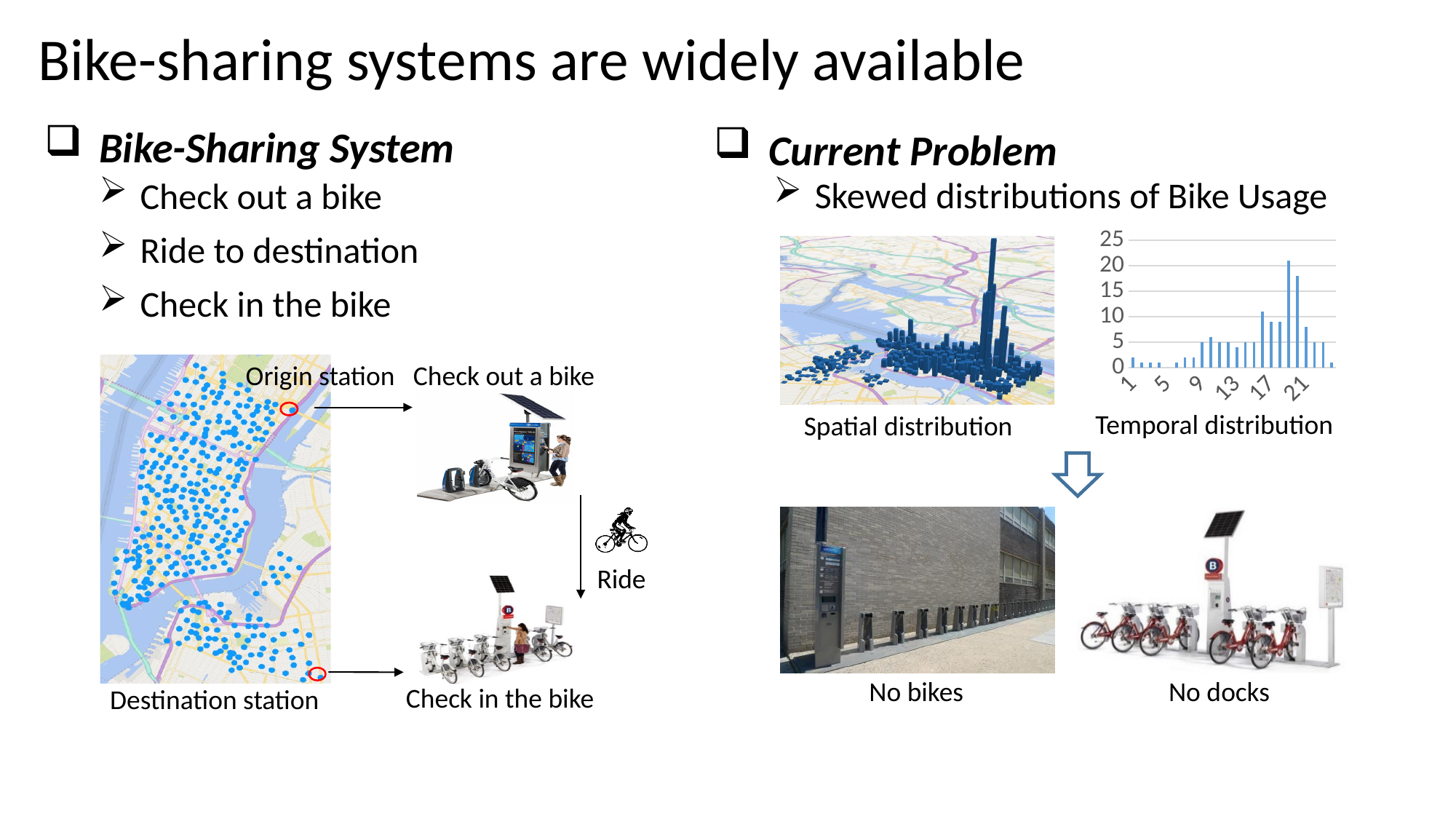
In the 'Temporal distribution' bar chart, is the value at tick 5 greater or less than 5? less In the 'Temporal distribution' bar chart, what is the highest value shown on the y axis? 25 What kind of chart is the 'Temporal distribution' chart on the slide? bar chart In the 'Temporal distribution' bar chart, is the value at tick 1 greater or less than 5? less In the 'Temporal distribution' bar chart, which is larger, the bar at tick 17 or the bar at tick 5? tick 17 In the 'Temporal distribution' bar chart, is the tallest bar greater or less than 15? greater In the 'Temporal distribution' bar chart, which is larger, the bar at tick 9 or the bar at tick 1? tick 9 What is the caption under the bar chart on the right side of the slide? Temporal distribution In the 'Temporal distribution' bar chart, do the values generally rise or fall from tick 1 to tick 17? rise